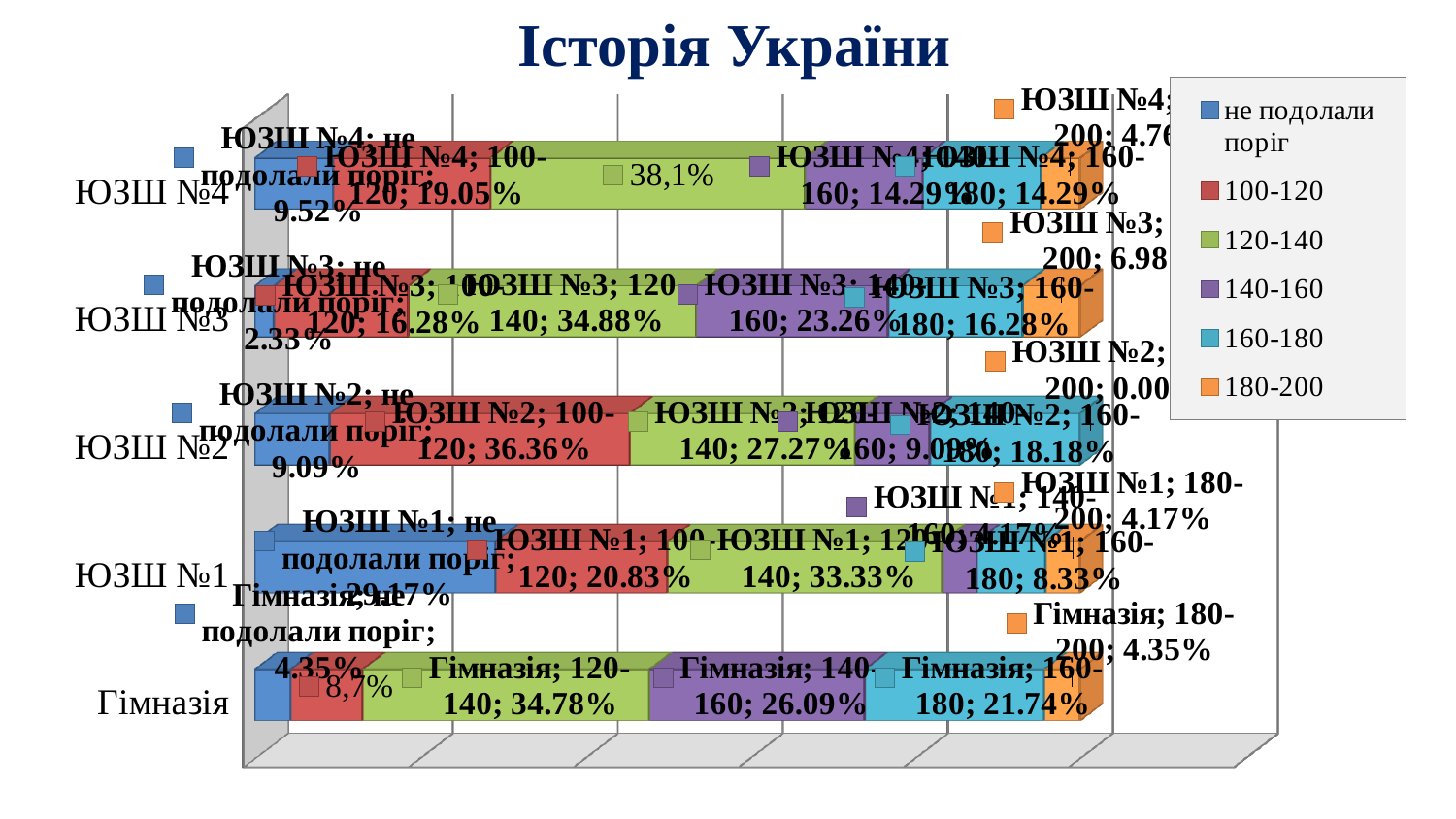
What is the value for the 100-120 segment of ЮЗШ №2? 36.36% What is the value for the 140-160 segment of Гімназія? 26.09% How many series does the legend list? 6 What is the title of the chart? Історія України How many schools (categories) are shown on the chart? 5 Which school has the lowest value for the 180-200 segment? ЮЗШ №2 Which school has the highest value for 'не подолали поріг'? ЮЗШ №1 What is the value for the 160-180 segment of Гімназія? 21.74% What is the difference between the 120-140 values of ЮЗШ №3 and Гімназія? 0.10% What kind of chart is shown on the slide? stacked bar chart What is the value for the 180-200 segment of ЮЗШ №3? 6.98% What is the value for the 120-140 segment of ЮЗШ №3? 34.88%